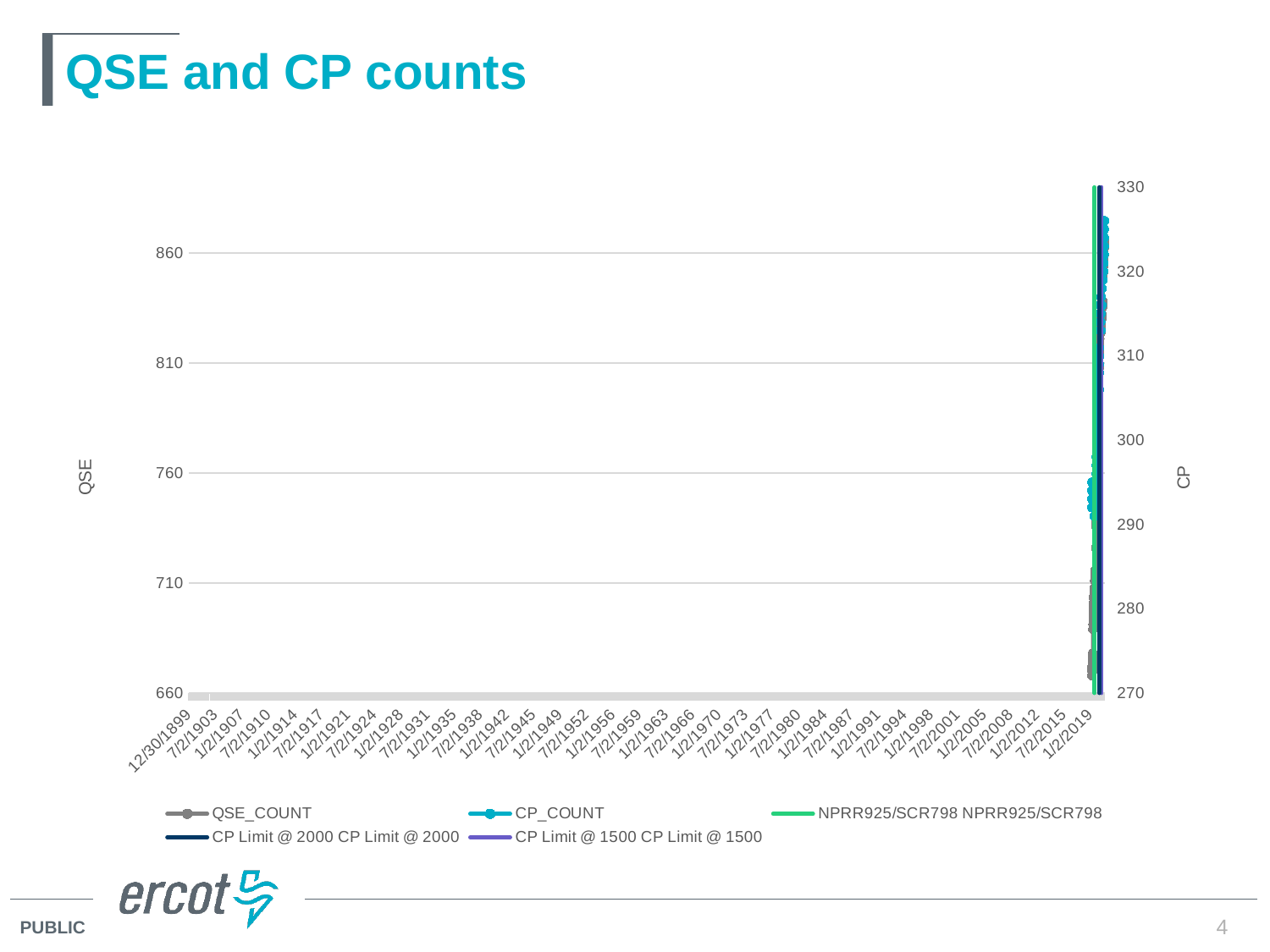
How many series does the legend list? 5 What is the title of the chart? QSE and CP counts Is the lowest CP_COUNT value on the right axis greater or less than 280? greater What are the labels of the left and right vertical axes? QSE (left) and CP (right) Is the highest CP_COUNT value on the right axis greater or less than 320? greater What kind of chart is shown on the slide? line chart